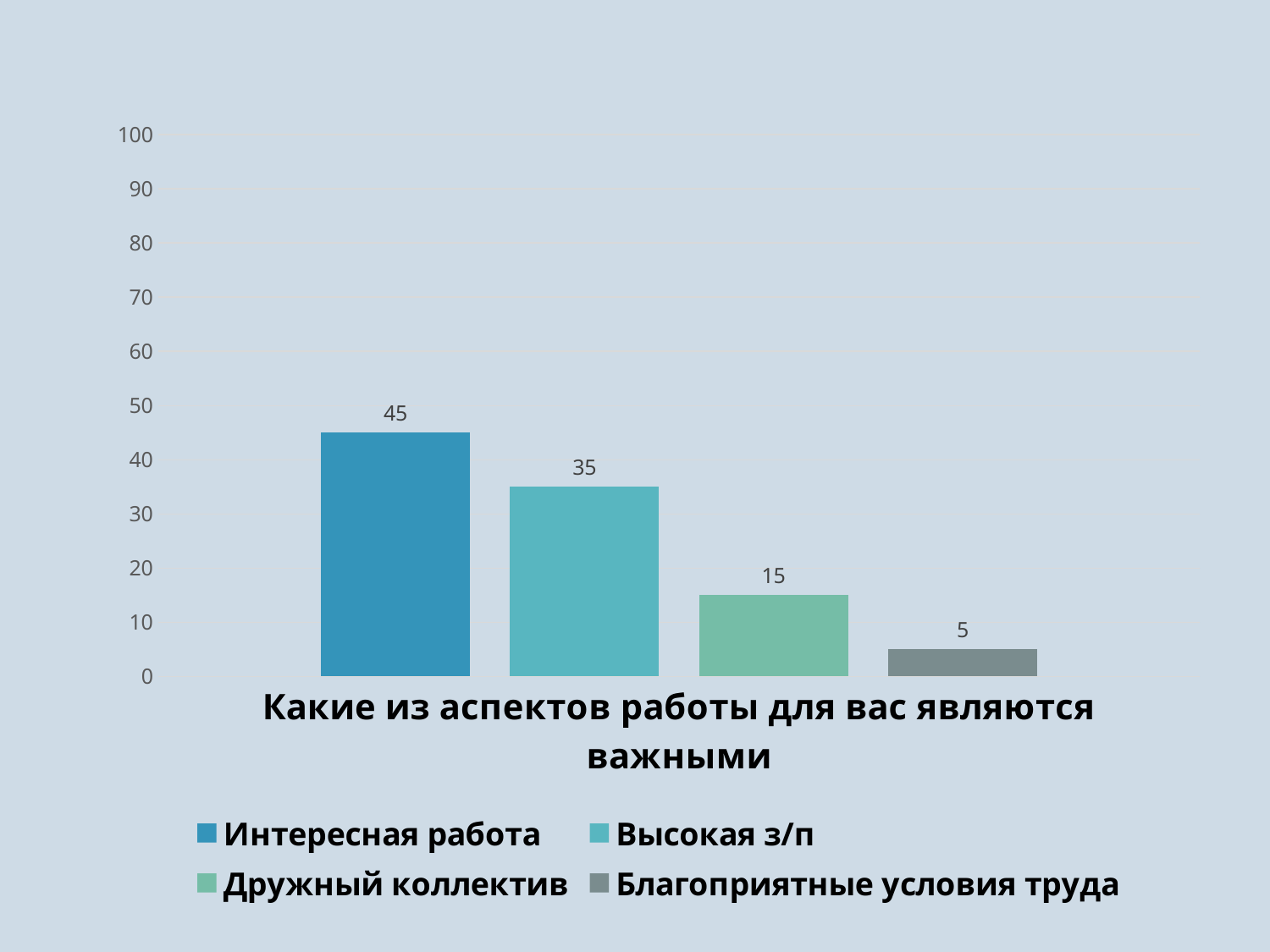
How many bars are plotted in the chart? 4 What is the value for Высокая з/п? 35 What is the value for Благоприятные условия труда? 5 Is the value for Высокая з/п greater or less than 40? less Which category has the highest value? Интересная работа What is the value for Дружный коллектив? 15 Which category has the lowest value? Благоприятные условия труда Which is larger, the value for Дружный коллектив or the value for Благоприятные условия труда? Дружный коллектив What kind of chart is shown on the slide? bar chart What is the difference between the values for Интересная работа and Высокая з/п? 10 What is the value for Интересная работа? 45 How many entries does the legend list? 4